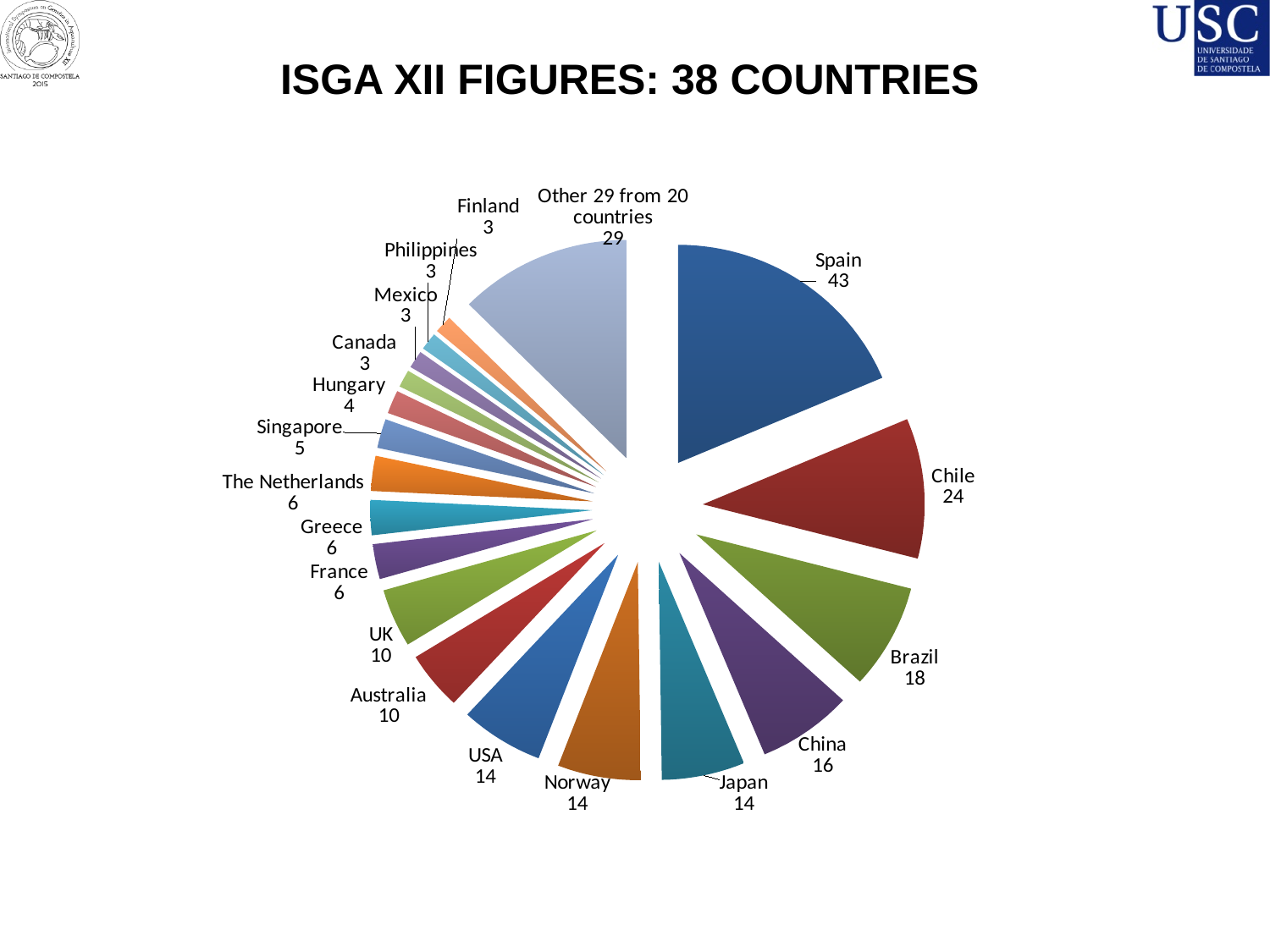
How many slices does the pie chart have? 19 What is the value for Spain? 43 What is the value for Chile? 24 What is the title of the slide? ISGA XII FIGURES: 38 COUNTRIES What is the difference between the values for Brazil and China? 2 Which country has the largest slice in the pie chart? Spain Which is larger, the value for Norway or the value for Australia? Norway What is the value for Brazil? 18 What type of chart is shown on the slide? pie chart What is the difference between the values for Spain and Chile? 19 What is the smallest value shown for any slice in the pie chart? 3 What is the value for Singapore? 5